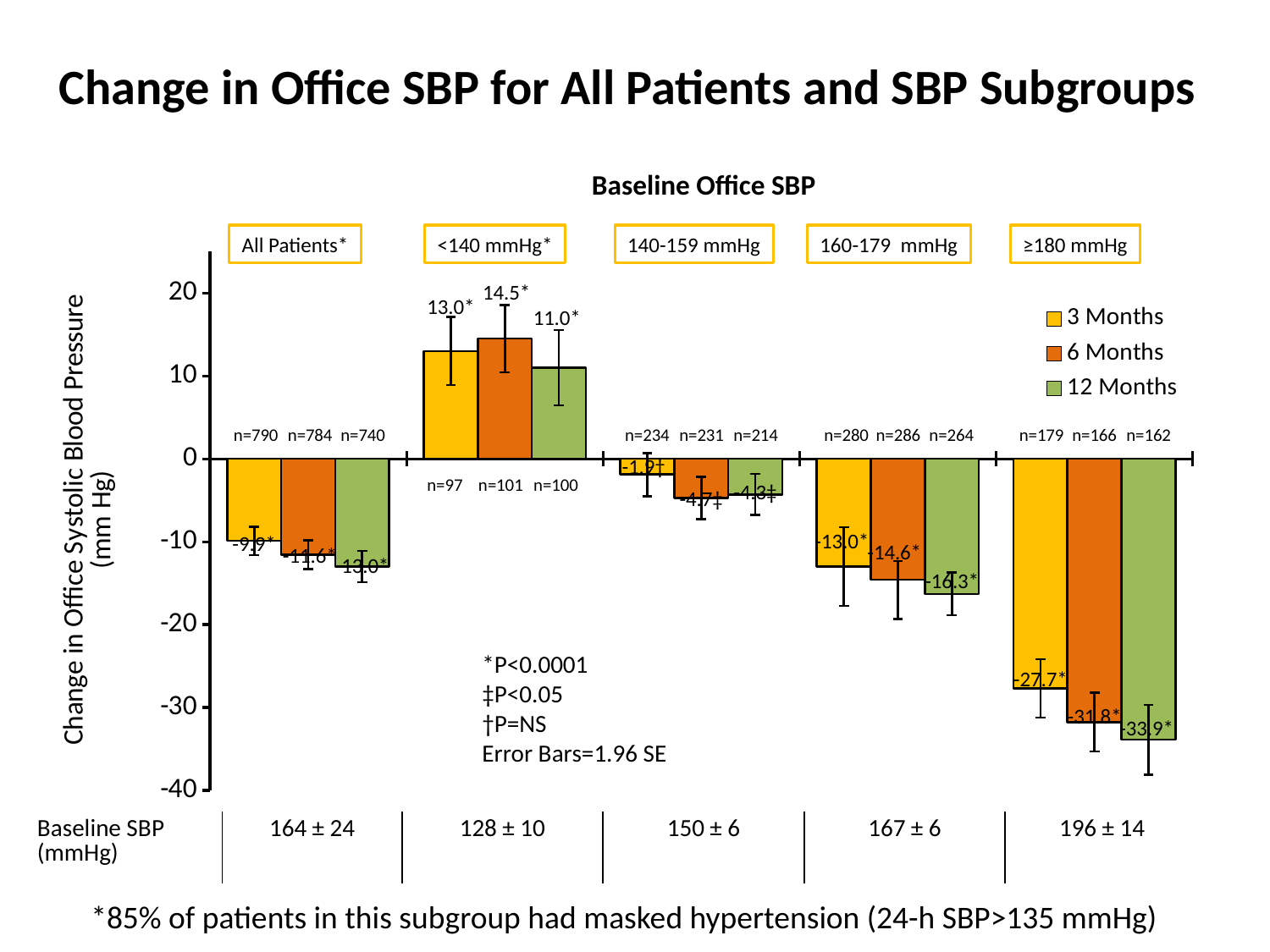
Which bar has the highest value on the chart? 6 Months for <140 mmHg (14.5) Which is larger, the 6 Months value for All Patients or the 6 Months value for the 160-179 mmHg subgroup? All Patients (-11.6) Which subgroup has the lowest (most negative) 12 Months value? ≥180 mmHg What kind of chart is shown on the slide? Bar chart What is the difference between the 3 Months and 12 Months values for the ≥180 mmHg subgroup? 6.2 What is the 3 Months value for the 140-159 mmHg subgroup? -1.9 What is the 12 Months value for All Patients? -13.0 What is the 12 Months value for the ≥180 mmHg subgroup? -33.9 How many patient groups are shown on the x axis? 5 What is the 6 Months value for the <140 mmHg subgroup? 14.5 What is the difference between the 6 Months and 12 Months values for the <140 mmHg subgroup? 3.5 How many series does the legend list? 3